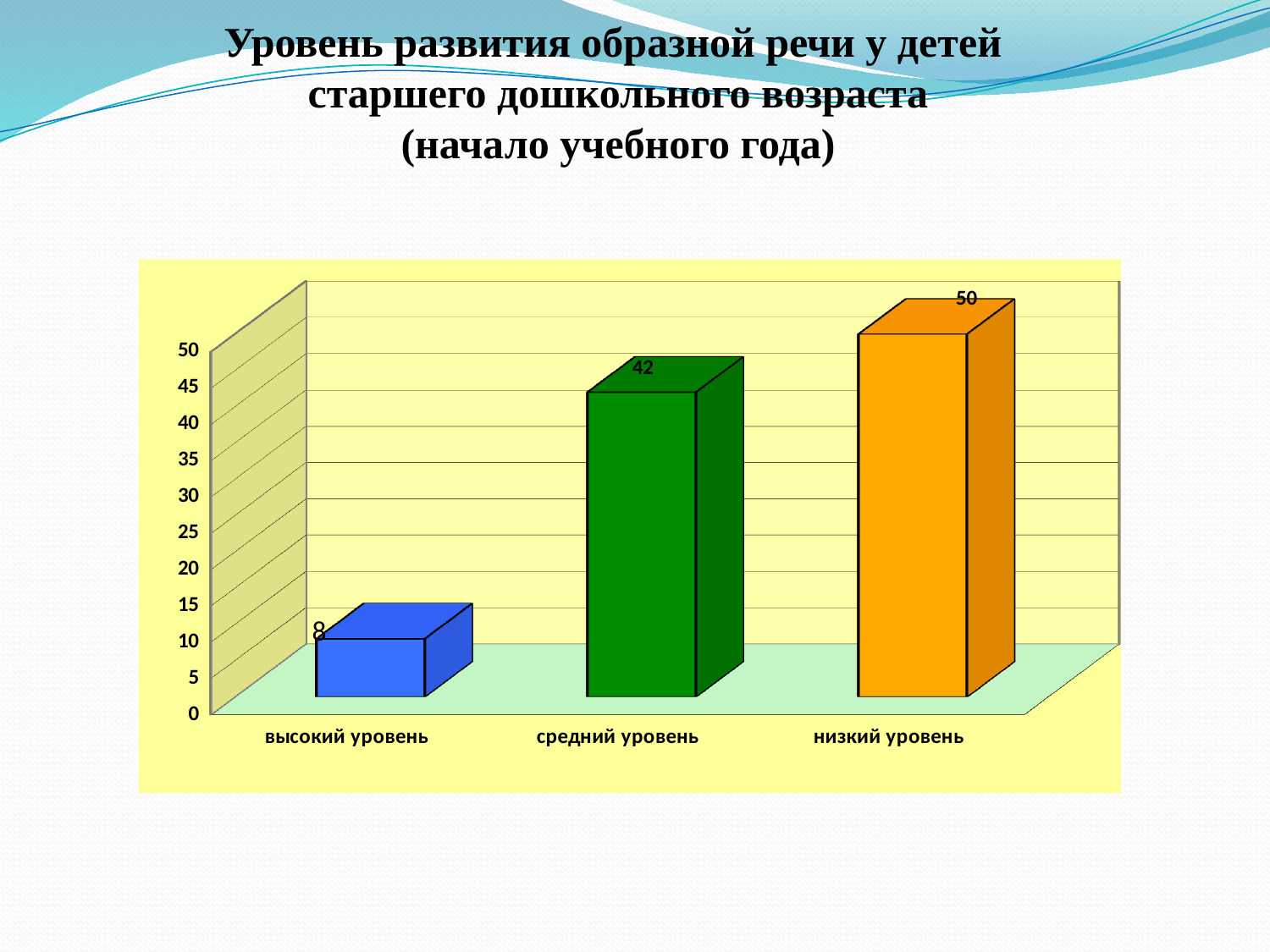
What is the value for низкий уровень? 50 What is the value for средний уровень? 42 What kind of chart is shown on the slide? bar chart Is the value for средний уровень greater or less than 40? greater What is the value for высокий уровень? 8 What is the difference between the values for низкий уровень and средний уровень? 8 What is the difference between the values for средний уровень and высокий уровень? 34 Which category has the lowest value? высокий уровень Do the values rise or fall from left to right along the x axis? rise Which category has the highest value? низкий уровень How many categories are shown on the x axis? 3 Which is larger, the value for средний уровень or the value for высокий уровень? средний уровень